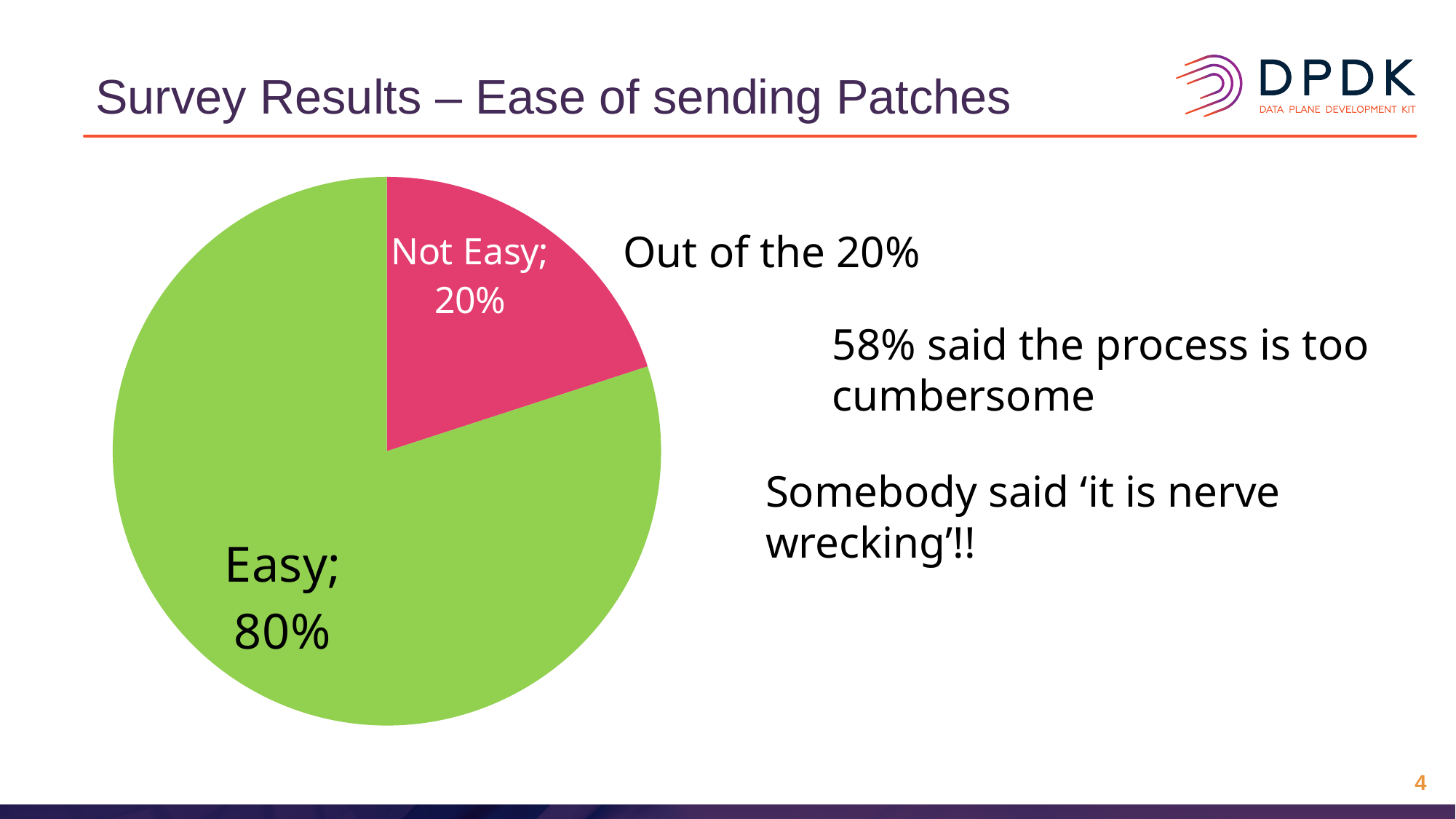
What share of the pie is labelled "Not Easy"? 20% What is the difference in percentage points between the Easy and Not Easy slices? 60 What kind of chart is shown on the slide? pie chart What share of the pie is labelled "Easy"? 80% What colour is the Not Easy slice of the pie? pink Which slice of the pie is the largest? Easy What do the two slices of the pie add up to? 100% How many slices does the pie chart have? 2 Which slice of the pie is the smallest? Not Easy What colour is the Easy slice of the pie? green Which is larger, the Easy slice or the Not Easy slice? Easy